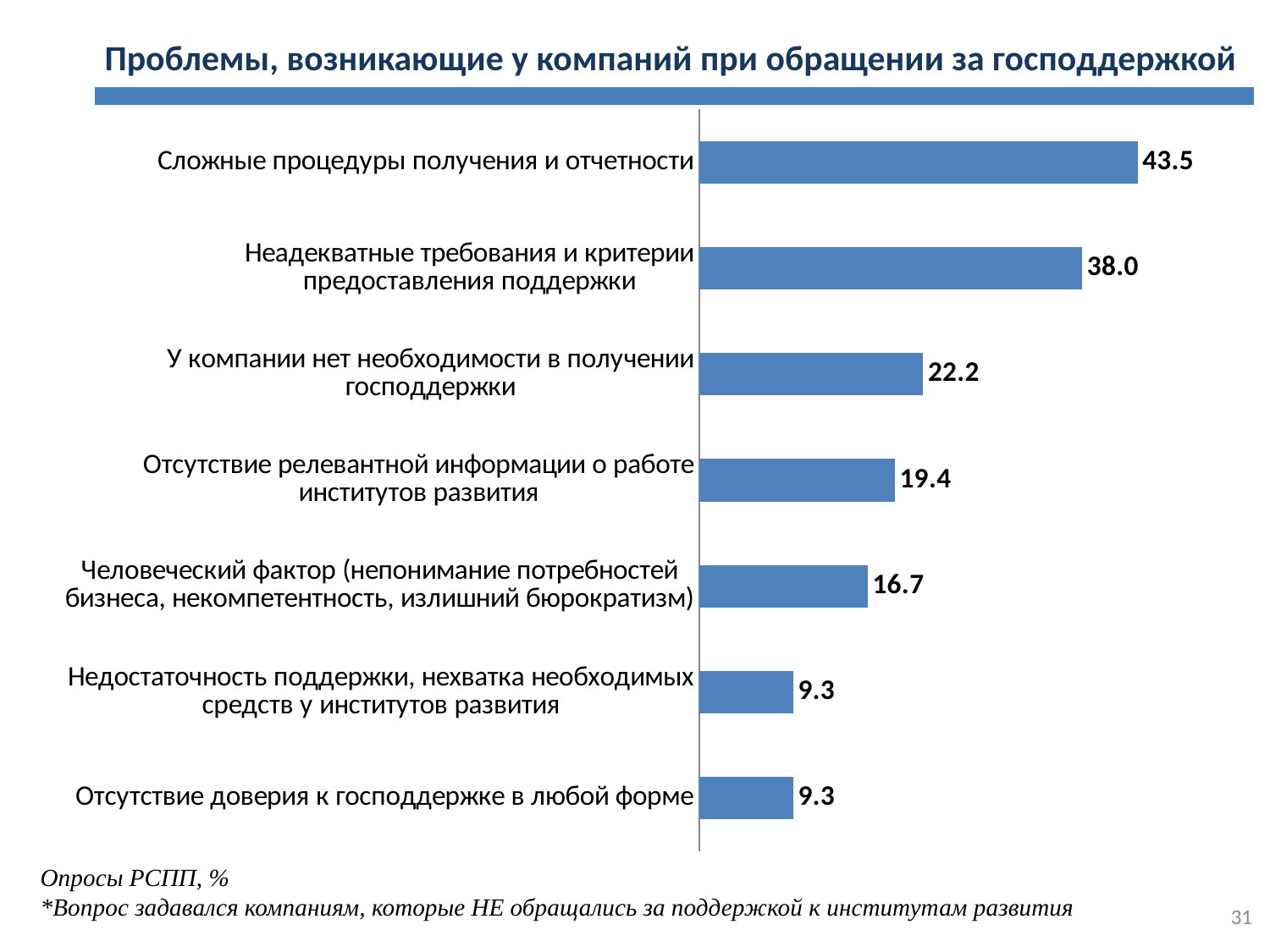
Which is larger: the value for «У компании нет необходимости в получении господдержки» or for «Человеческий фактор (непонимание потребностей бизнеса, некомпетентность, излишний бюрократизм)»? У компании нет необходимости в получении господдержки What is the value for «Сложные процедуры получения и отчетности»? 43.5 What is the title of the chart on the slide? Проблемы, возникающие у компаний при обращении за господдержкой What is the lowest value shown on the chart? 9.3 What is the difference between the values for «Сложные процедуры получения и отчетности» and «Неадекватные требования и критерии предоставления поддержки»? 5.5 What is the difference between the values for «У компании нет необходимости в получении господдержки» and «Отсутствие релевантной информации о работе институтов развития»? 2.8 Which category has the highest value? Сложные процедуры получения и отчетности What is the value for «Человеческий фактор (непонимание потребностей бизнеса, некомпетентность, излишний бюрократизм)»? 16.7 How many categories are shown on the chart? 7 What is the value for «Неадекватные требования и критерии предоставления поддержки»? 38.0 What kind of chart is shown on the slide? Bar chart What is the value for «Отсутствие релевантной информации о работе институтов развития»? 19.4